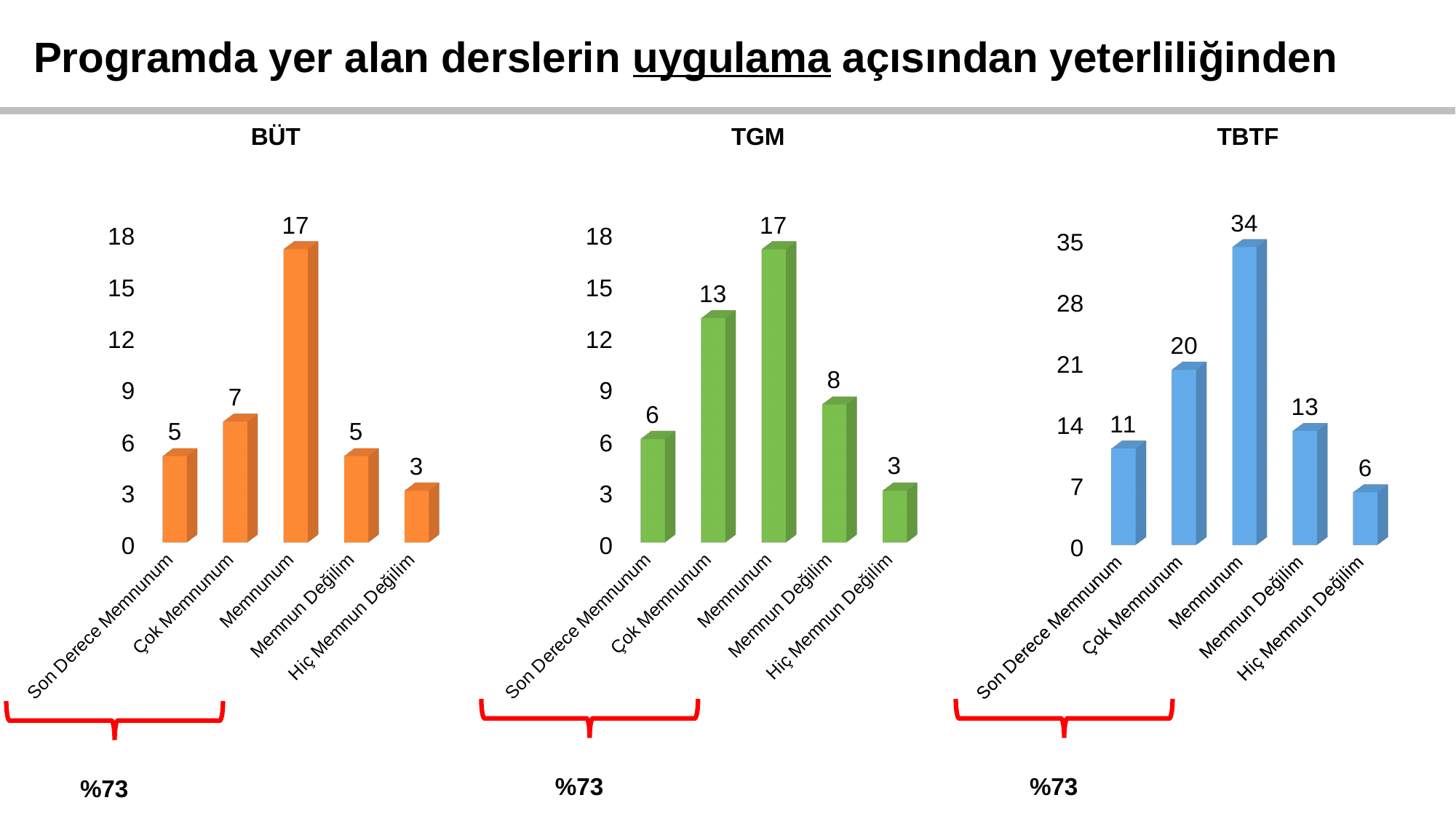
How many categories does the BÜT chart show? 5 In the TGM chart, which category has the lowest value? Hiç Memnun Değilim How many charts are on the slide? 3 In the TBTF chart, which category has the highest value? Memnunum What colour are the bars in the TBTF chart? blue What type of chart is the TGM chart? bar chart In the BÜT chart, what is the value for Memnunum? 17 In the TBTF chart, what is the value for Hiç Memnun Değilim? 6 In the TGM chart, what is the value for Çok Memnunum? 13 In the BÜT chart, what is the difference between Memnunum and Çok Memnunum? 10 In the TBTF chart, what is the difference between Memnunum and Çok Memnunum? 14 In the TGM chart, which is larger: Memnun Değilim or Son Derece Memnunum? Memnun Değilim